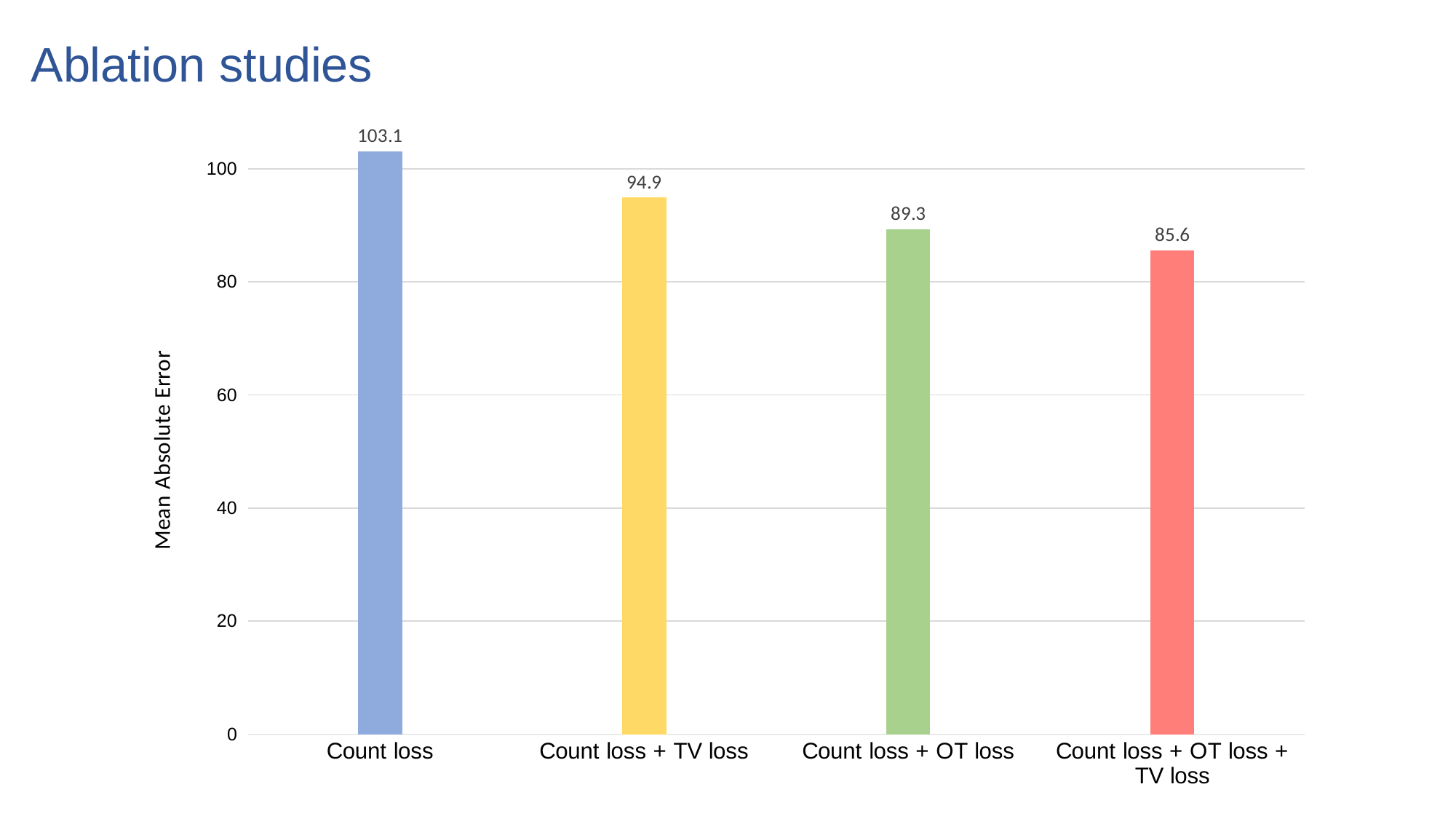
What is the Mean Absolute Error for Count loss + OT loss? 89.3 What kind of chart is shown on the slide? Bar chart Do the values rise or fall from left to right along the x axis? Fall What is the Mean Absolute Error for Count loss? 103.1 Is the value for Count loss + OT loss greater or less than 80? greater Which category has the highest Mean Absolute Error? Count loss What is the Mean Absolute Error for Count loss + OT loss + TV loss? 85.6 How many categories are shown on the x axis? 4 Which category has the lowest Mean Absolute Error? Count loss + OT loss + TV loss Which has a larger Mean Absolute Error, Count loss + TV loss or Count loss + OT loss? Count loss + TV loss What is the difference in Mean Absolute Error between Count loss and Count loss + OT loss + TV loss? 17.5 What is the Mean Absolute Error for Count loss + TV loss? 94.9